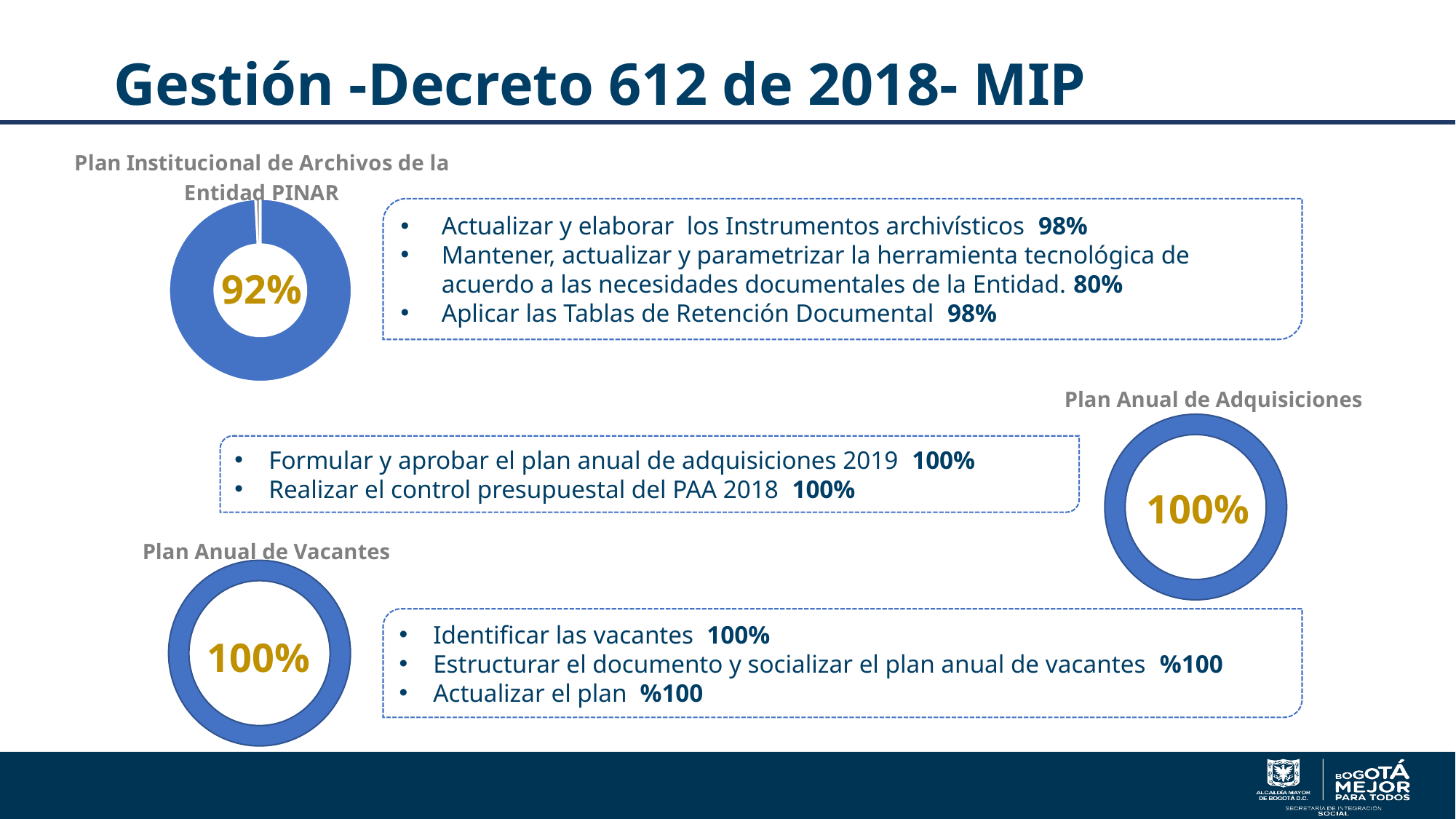
What is the difference between the value in the 'Plan Anual de Vacantes' chart and the value in the 'Plan Institucional de Archivos de la Entidad PINAR' chart? 8% What value is shown in the centre of the 'Plan Anual de Vacantes' chart? 100% What kind of chart is used for 'Plan Institucional de Archivos de la Entidad PINAR'? Doughnut chart Which of the three charts shows the lowest percentage? Plan Institucional de Archivos de la Entidad PINAR What value is shown in the centre of the 'Plan Institucional de Archivos de la Entidad PINAR' chart? 92% What value is shown in the centre of the 'Plan Anual de Adquisiciones' chart? 100% What kind of chart is used for 'Plan Anual de Vacantes'? Doughnut chart What is the title of the chart located on the right side of the slide? Plan Anual de Adquisiciones What is the title of the chart located at the top left of the slide? Plan Institucional de Archivos de la Entidad PINAR How many doughnut charts are on the slide? 3 Is the value shown in the 'Plan Institucional de Archivos de la Entidad PINAR' chart larger or smaller than the value in the 'Plan Anual de Adquisiciones' chart? Smaller